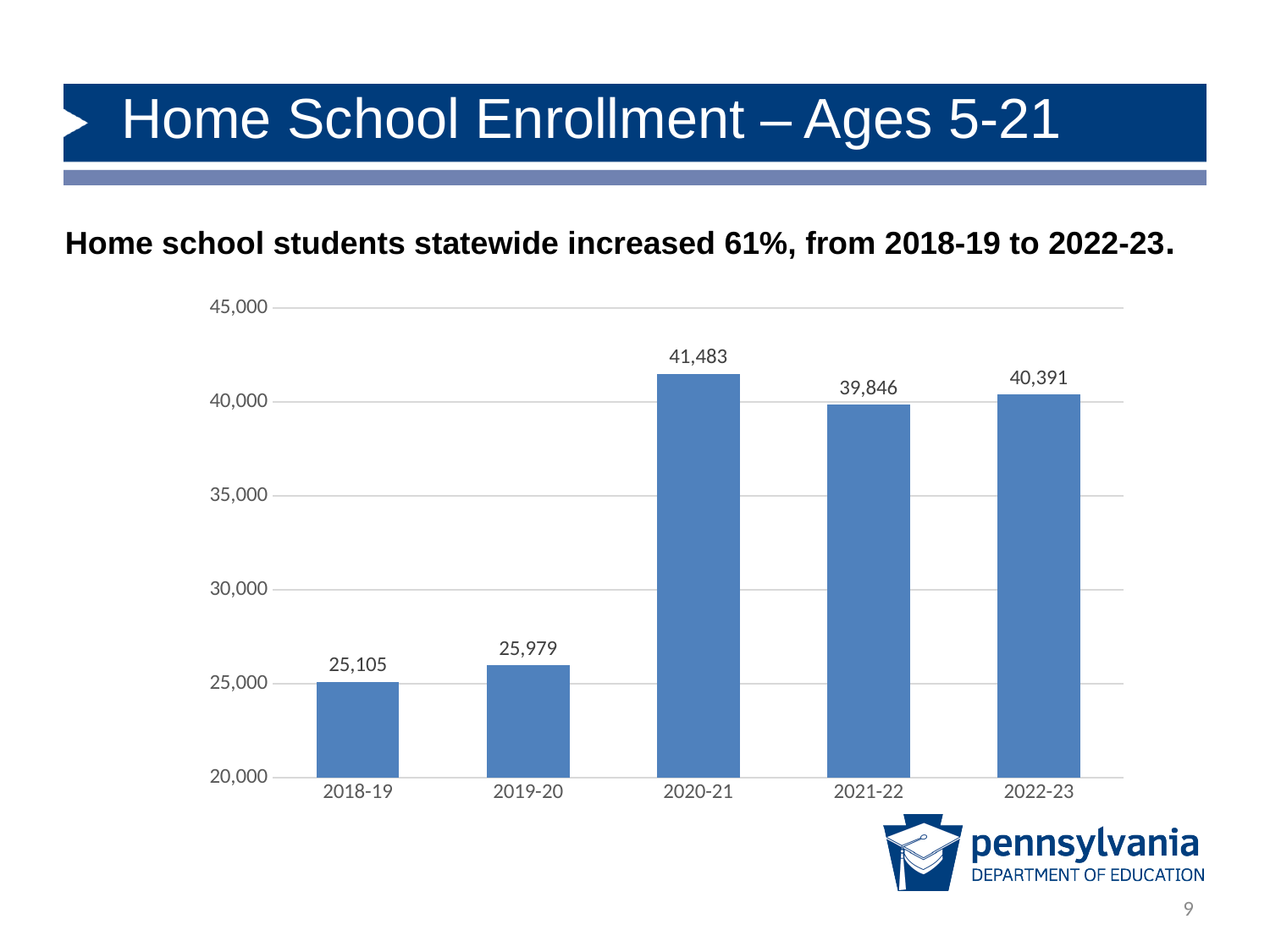
What is the home school enrollment value for 2018-19? 25,105 What kind of chart is shown on the slide? bar chart What is the home school enrollment value for 2022-23? 40,391 Which school year has the lowest home school enrollment? 2018-19 Does home school enrollment rise or fall from 2018-19 to 2020-21? rise What is the home school enrollment value for 2020-21? 41,483 Is the value for 2021-22 greater or less than 40,000? less What is the difference in enrollment between 2022-23 and 2018-19? 15,286 Which school year has the highest home school enrollment? 2020-21 Which is larger, the enrollment for 2019-20 or for 2021-22? 2021-22 How many school years are shown on the chart? 5 What is the difference in enrollment between 2020-21 and 2021-22? 1,637